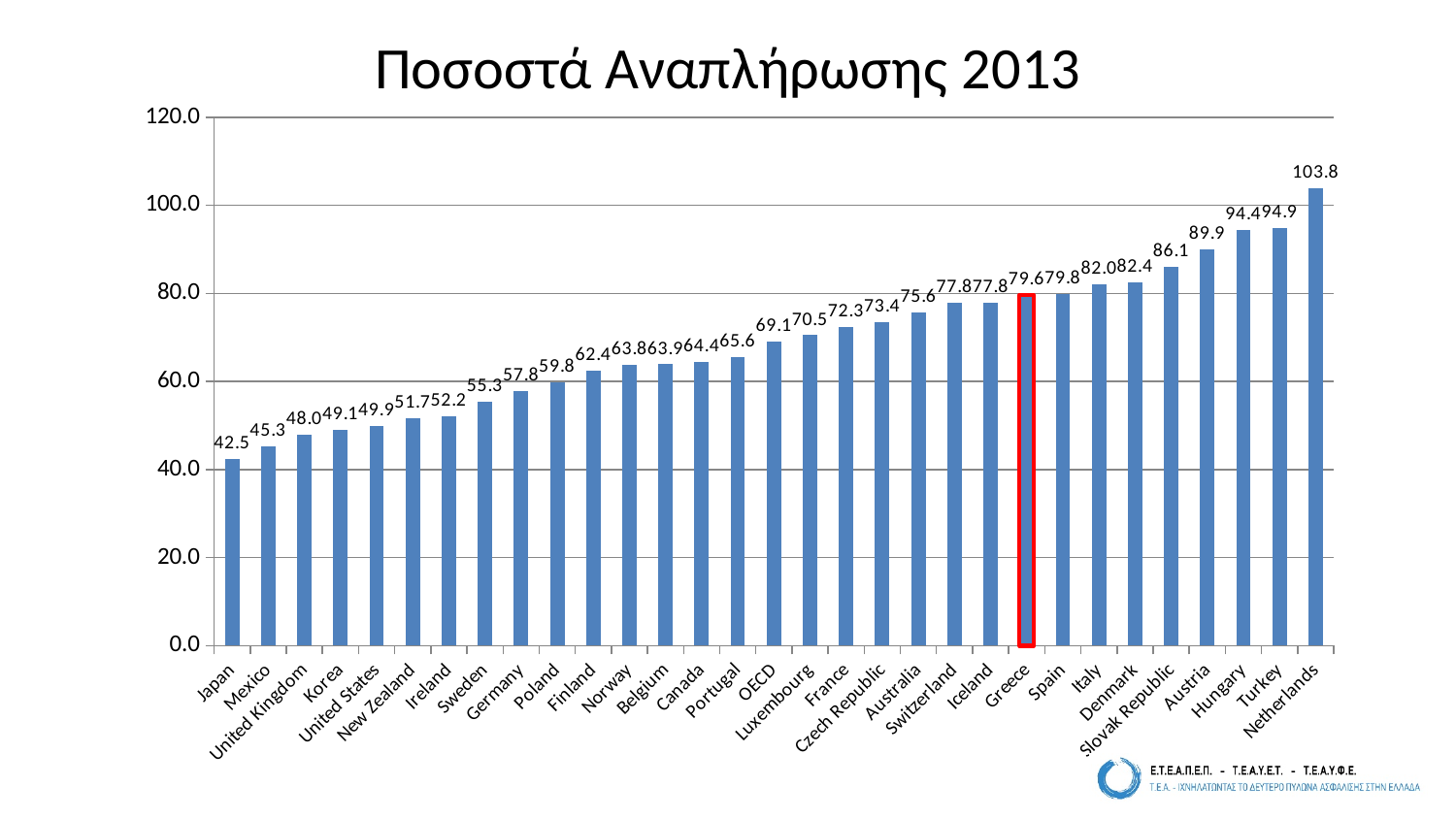
Do the values rise or fall from left to right along the x axis? rise Which is larger, the value for Austria or the value for Slovak Republic? Austria Is the value for Germany greater or less than 60.0? less What is the value for OECD? 69.1 Which country has the highest value? Netherlands What is the difference between the values for Netherlands and Japan? 61.3 How many countries/categories are shown on the x axis? 31 What is the difference between the values for Greece and OECD? 10.5 What kind of chart is shown on the slide? bar chart What is the value for Greece? 79.6 Which country has the lowest value? Japan What is the value for Netherlands? 103.8